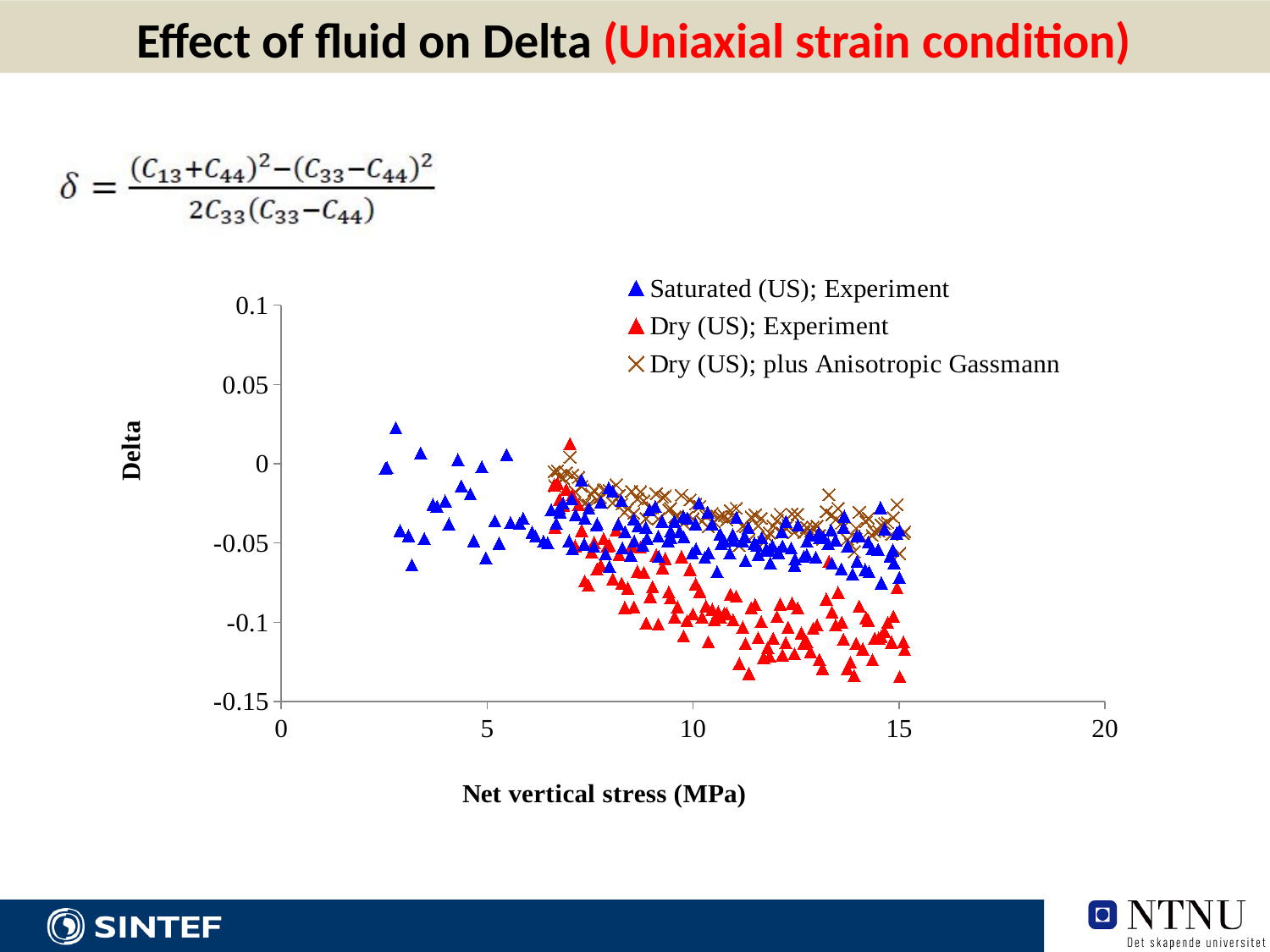
Does the Dry (US); Experiment series rise or fall as net vertical stress increases? fall At around 12 MPa, which series has higher Delta values: Saturated (US); Experiment or Dry (US); Experiment? Saturated (US); Experiment Are the Dry (US); Experiment values near 12 MPa greater or less than -0.05? less Are the Saturated (US); Experiment values near 15 MPa greater or less than -0.1? greater How many series does the legend list? 3 Are the Dry (US); plus Anisotropic Gassmann values near 10 MPa greater or less than -0.05? greater Which series is plotted with x-shaped markers? Dry (US); plus Anisotropic Gassmann What is the title of the x axis? Net vertical stress (MPa) Which series has the lowest Delta values overall? Dry (US); Experiment What is the maximum value shown on the x axis? 20 At around 12 MPa, which series has higher Delta values: Dry (US); Experiment or Dry (US); plus Anisotropic Gassmann? Dry (US); plus Anisotropic Gassmann What kind of chart is shown on the slide? scatter chart